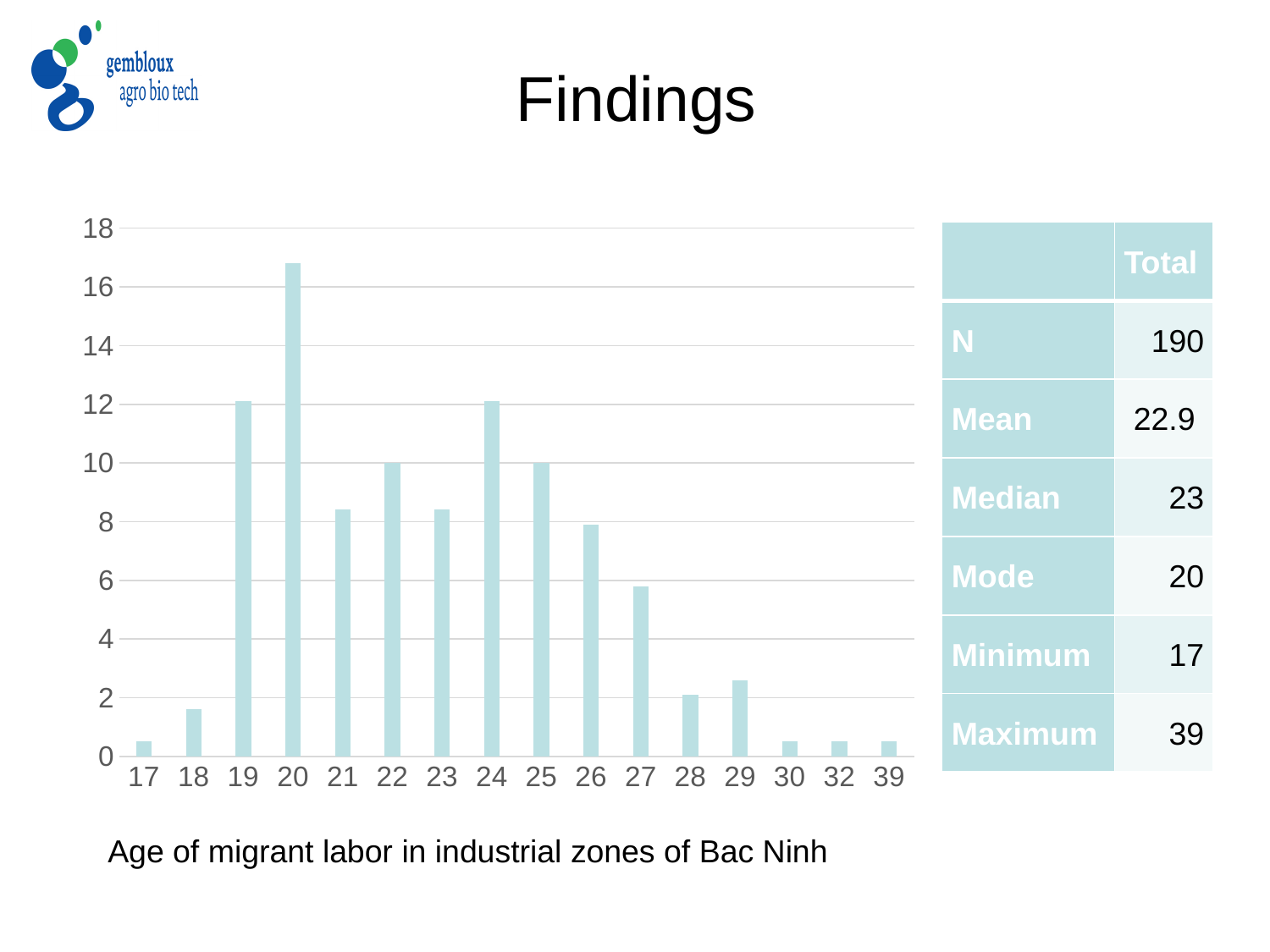
Is the value for age 18 greater or less than 2? less Is the value for age 27 greater or less than 4? greater What kind of chart is shown on the slide? bar chart Do the values rise or fall along the x axis from age 25 to age 28? fall What is the caption written below the chart? Age of migrant labor in industrial zones of Bac Ninh Which has the larger value, age 24 or age 20? 20 Which has the larger value, age 19 or age 21? 19 Which age has the highest bar in the chart? 20 Is the value for age 19 greater or less than 10? greater How many age categories are shown on the x axis of the chart? 16